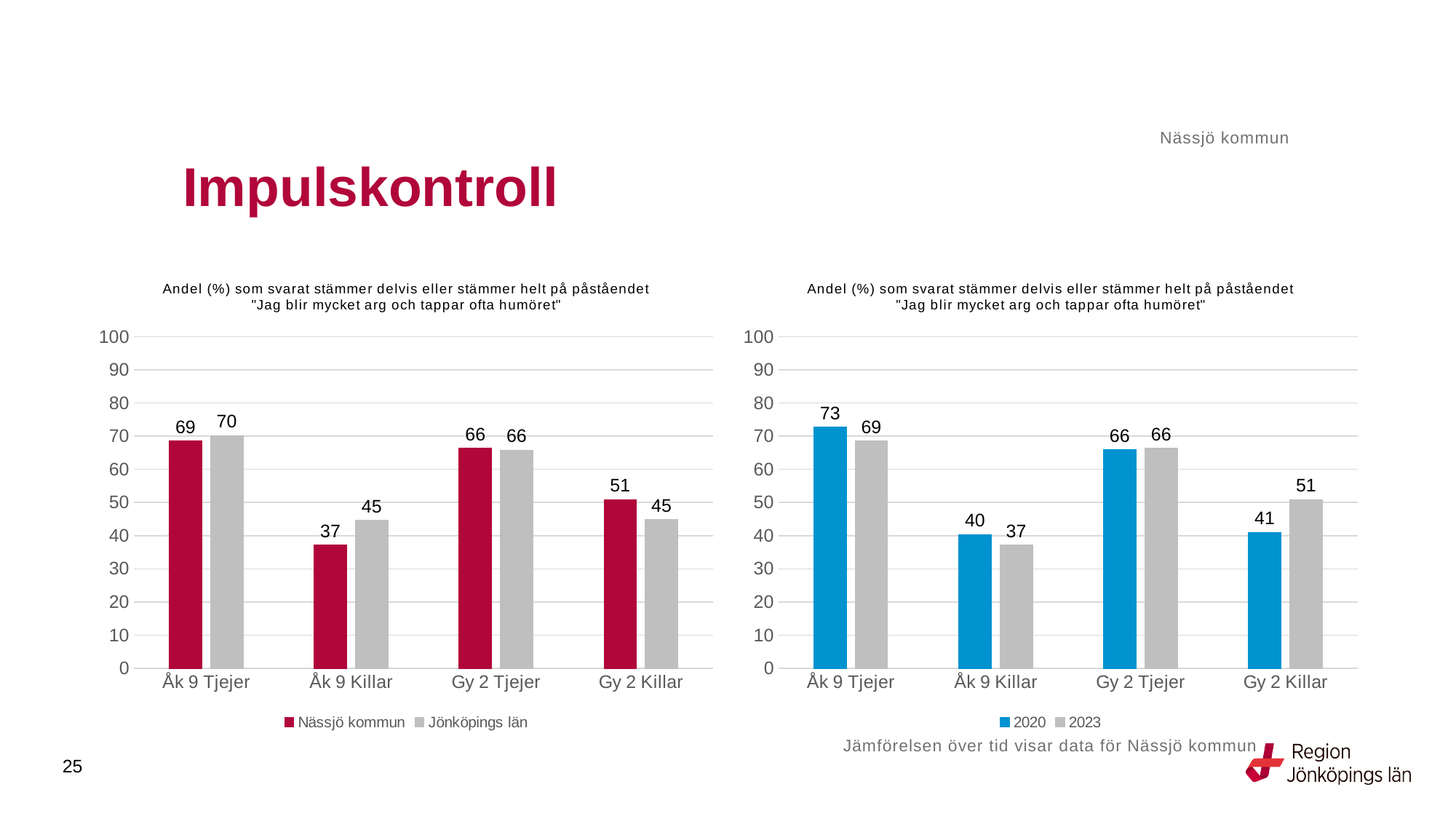
In the left chart, what is the value for Jönköpings län for Gy 2 Killar? 45 In the right chart, which is larger for Åk 9 Killar, the 2020 value or the 2023 value? 2020 In the right chart, what is the 2023 value for Gy 2 Killar? 51 In the left chart, what is the difference between Jönköpings län and Nässjö kommun for Åk 9 Killar? 8 How many categories are shown on the x axis of the left chart? 4 In the left chart, which category has the lowest value for Nässjö kommun? Åk 9 Killar In the right chart, which category has the highest 2020 value? Åk 9 Tjejer In the left chart, what is the value for Nässjö kommun for Åk 9 Killar? 37 In the right chart, what is the 2020 value for Åk 9 Tjejer? 73 What kind of chart is the left chart? Bar chart How many series does the legend of the right chart list? 2 In the right chart, what is the difference between the 2023 and 2020 values for Gy 2 Killar? 10